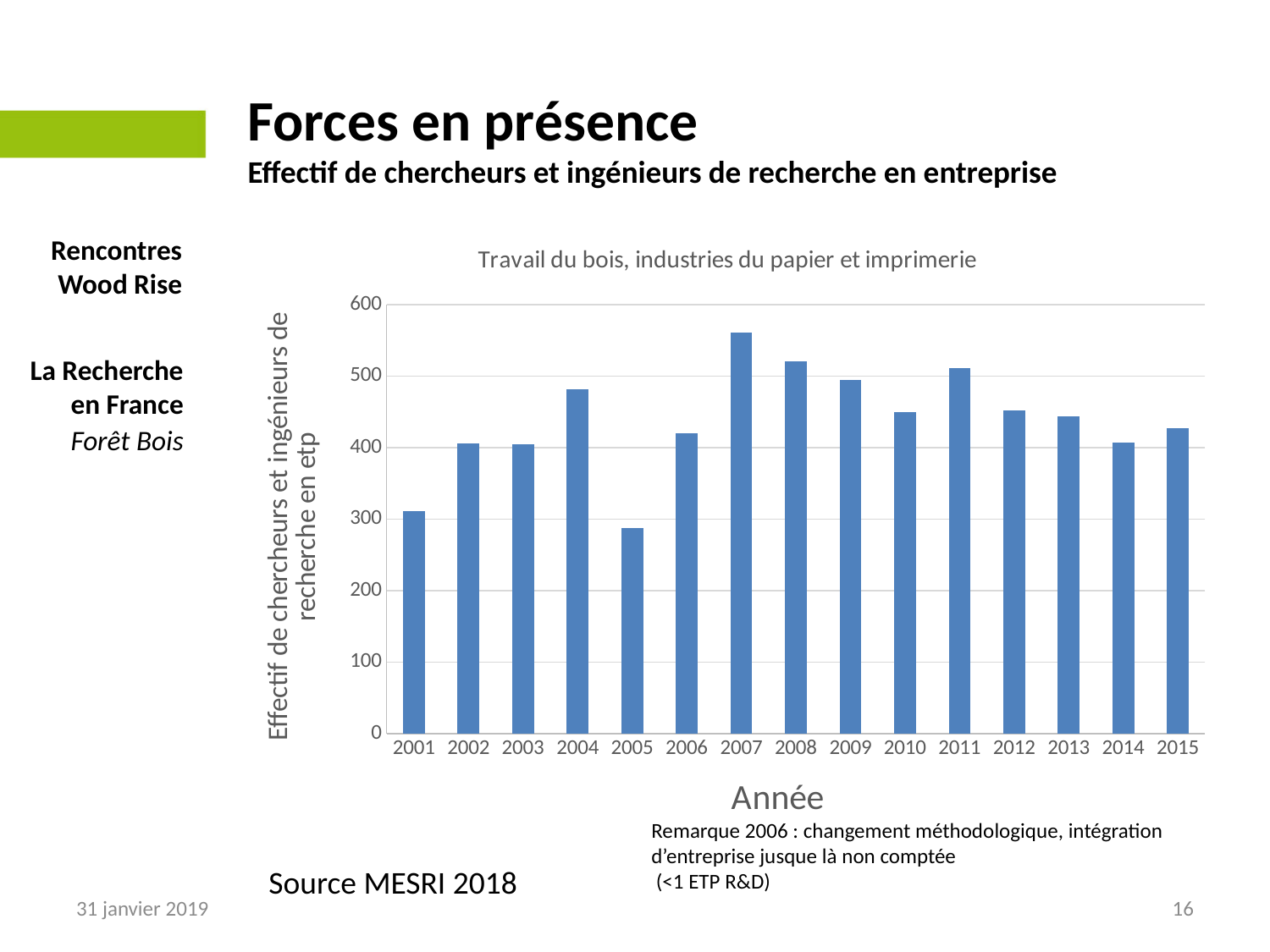
Is the value for 2001 greater or less than 400? less Is the value for 2010 greater or less than 500? less Which year has the larger value, 2001 or 2002? 2002 Which year has the highest value in the chart? 2007 Which year has the larger value, 2004 or 2006? 2004 Is the value for 2005 greater or less than 300? less What is the label of the x axis of the chart? Année How many years are plotted on the x axis of the chart? 15 What kind of chart is shown on the slide? bar chart What is the title of the chart? Travail du bois, industries du papier et imprimerie Which year has the lowest value in the chart? 2005